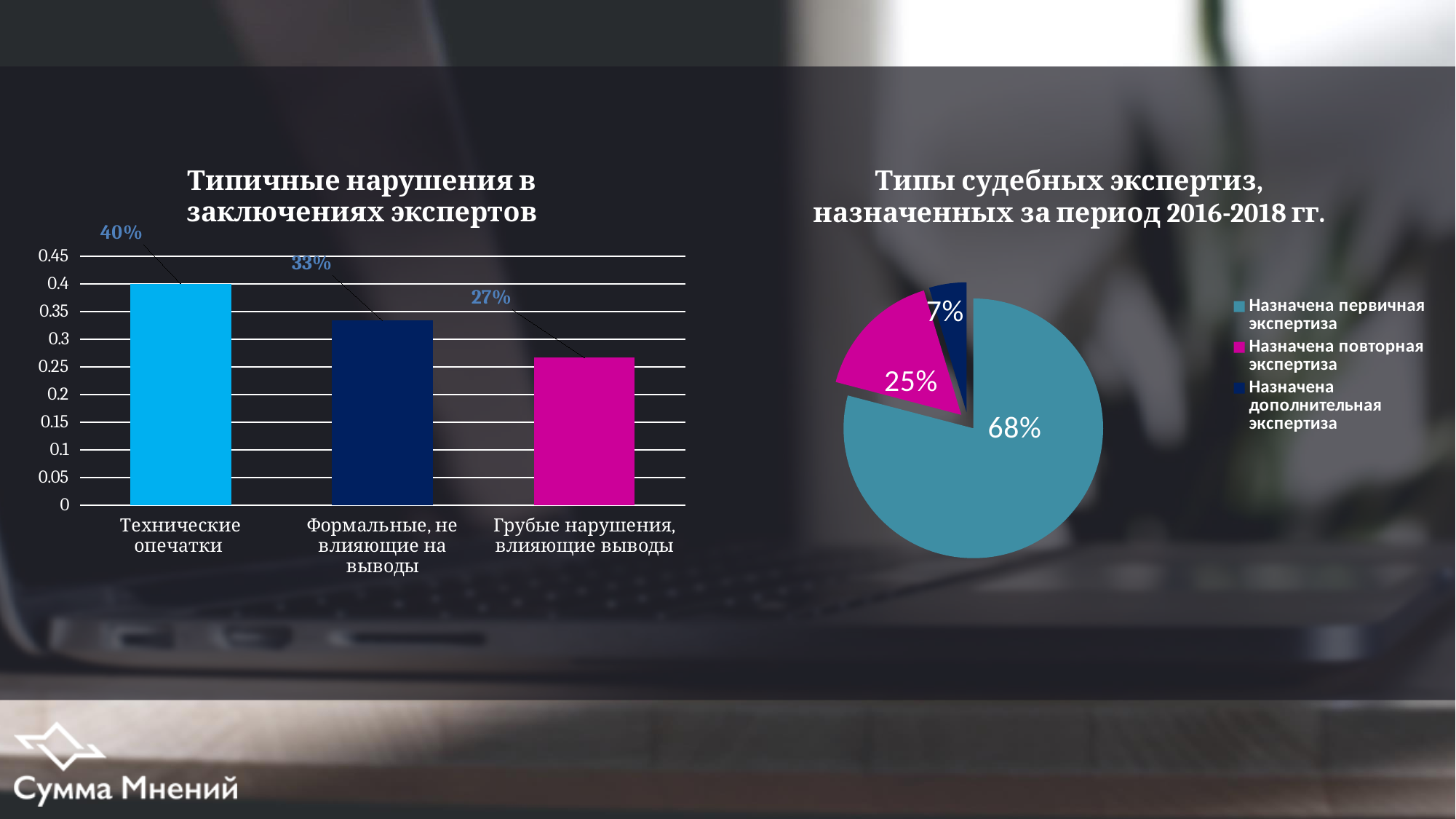
In the chart 'Типичные нарушения в заключениях экспертов', which category has the lowest value? Грубые нарушения, влияющие выводы In the chart 'Типы судебных экспертиз, назначенных за период 2016-2018 гг.', what share is 'Назначена повторная экспертиза'? 25% In the chart 'Типичные нарушения в заключениях экспертов', what is the value for 'Технические опечатки'? 40% In the chart 'Типичные нарушения в заключениях экспертов', which category has the highest value? Технические опечатки In the chart 'Типы судебных экспертиз, назначенных за период 2016-2018 гг.', which category has the smallest slice? Назначена дополнительная экспертиза What kind of chart is 'Типы судебных экспертиз, назначенных за период 2016-2018 гг.'? Pie chart In the chart 'Типичные нарушения в заключениях экспертов', how many categories are shown? 3 What kind of chart is 'Типичные нарушения в заключениях экспертов'? Bar chart In the chart 'Типичные нарушения в заключениях экспертов', what is the difference between 'Технические опечатки' and 'Формальные, не влияющие на выводы'? 7% In the chart 'Типичные нарушения в заключениях экспертов', do the values rise or fall from left to right? Fall In the chart 'Типичные нарушения в заключениях экспертов', what is the value for 'Грубые нарушения, влияющие выводы'? 27% In the chart 'Типы судебных экспертиз, назначенных за период 2016-2018 гг.', how many entries does the legend list? 3